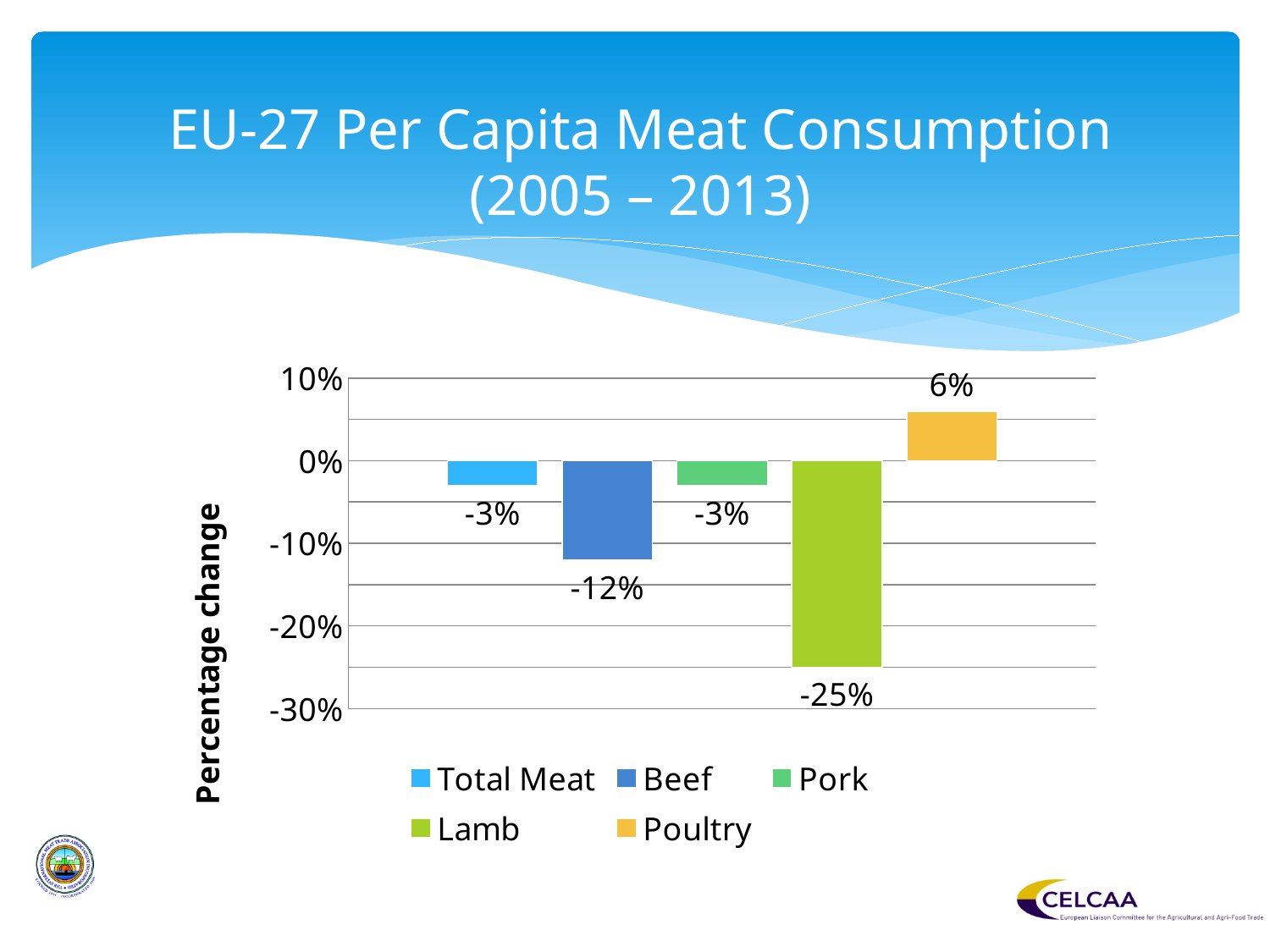
What is the label on the vertical axis of the chart? Percentage change What kind of chart is shown on the slide? Bar chart Which meat category shows the largest decline in per capita consumption? Lamb Which has a larger decline, Beef or Pork? Beef Which category has the highest percentage change? Poultry What is the percentage change for Poultry? 6% Is the value for Lamb greater or less than -20%? less What is the percentage change for Beef? -12% What is the difference between the percentage change for Beef and the percentage change for Lamb? 13 percentage points What is the percentage change for Total Meat? -3% How many series does the legend list? 5 What is the percentage change for Lamb? -25%